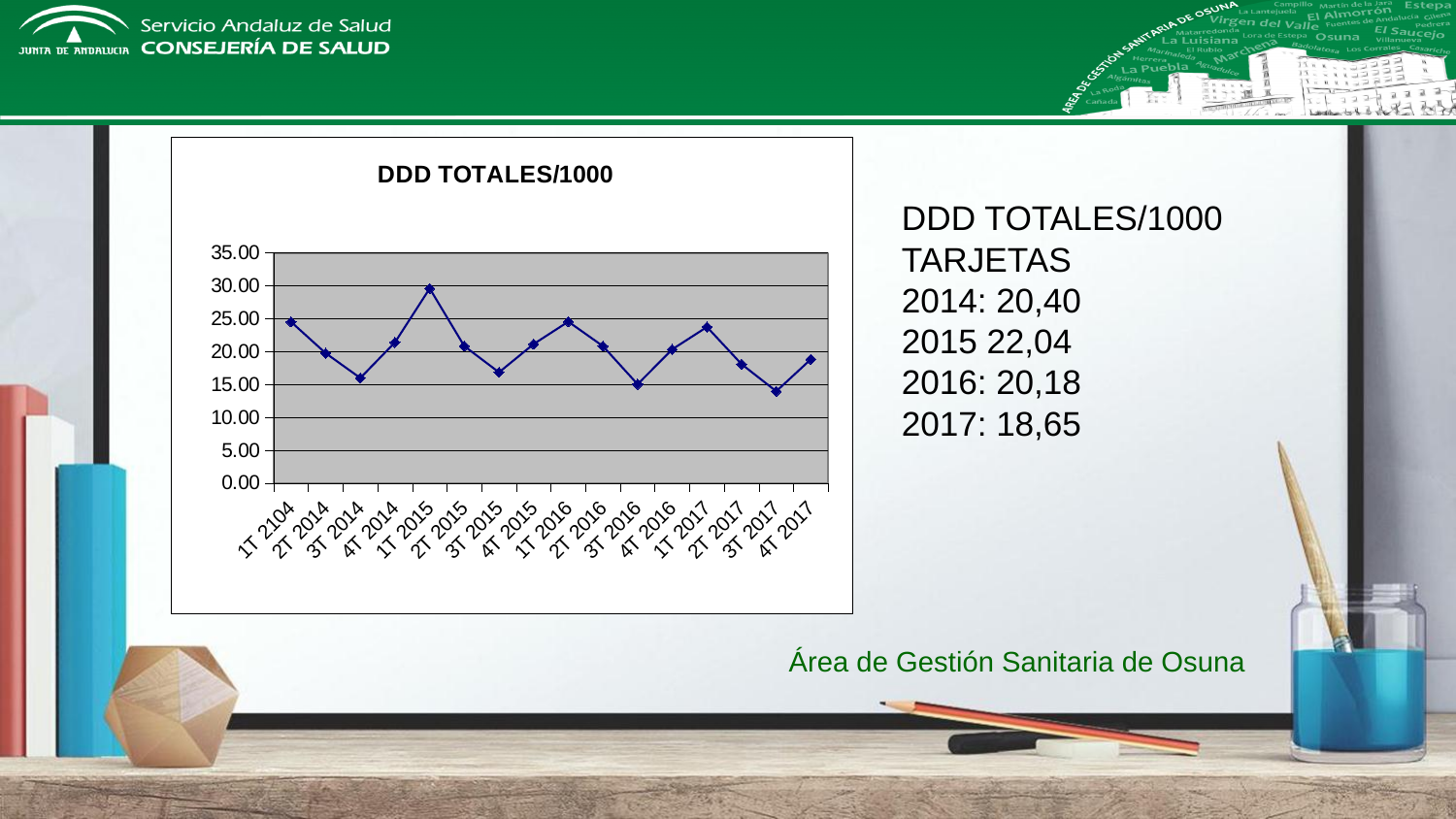
Is the value for 1T 2016 greater or less than 20.00? greater What is the label of the first category on the x axis? 1T 2104 Is the value for 1T 2015 greater or less than 25.00? greater How many data points are plotted on the chart? 16 Which quarter has the highest value on the chart? 1T 2015 Which is larger, the value for 3T 2014 or the value for 4T 2014? 4T 2014 Which is larger, the value for 1T 2015 or the value for 1T 2016? 1T 2015 Is the value for 3T 2014 greater or less than 20.00? less Do the values rise or fall from 1T 2015 to 3T 2015? fall What is the title of the chart? DDD TOTALES/1000 What kind of chart is shown on the slide? line chart